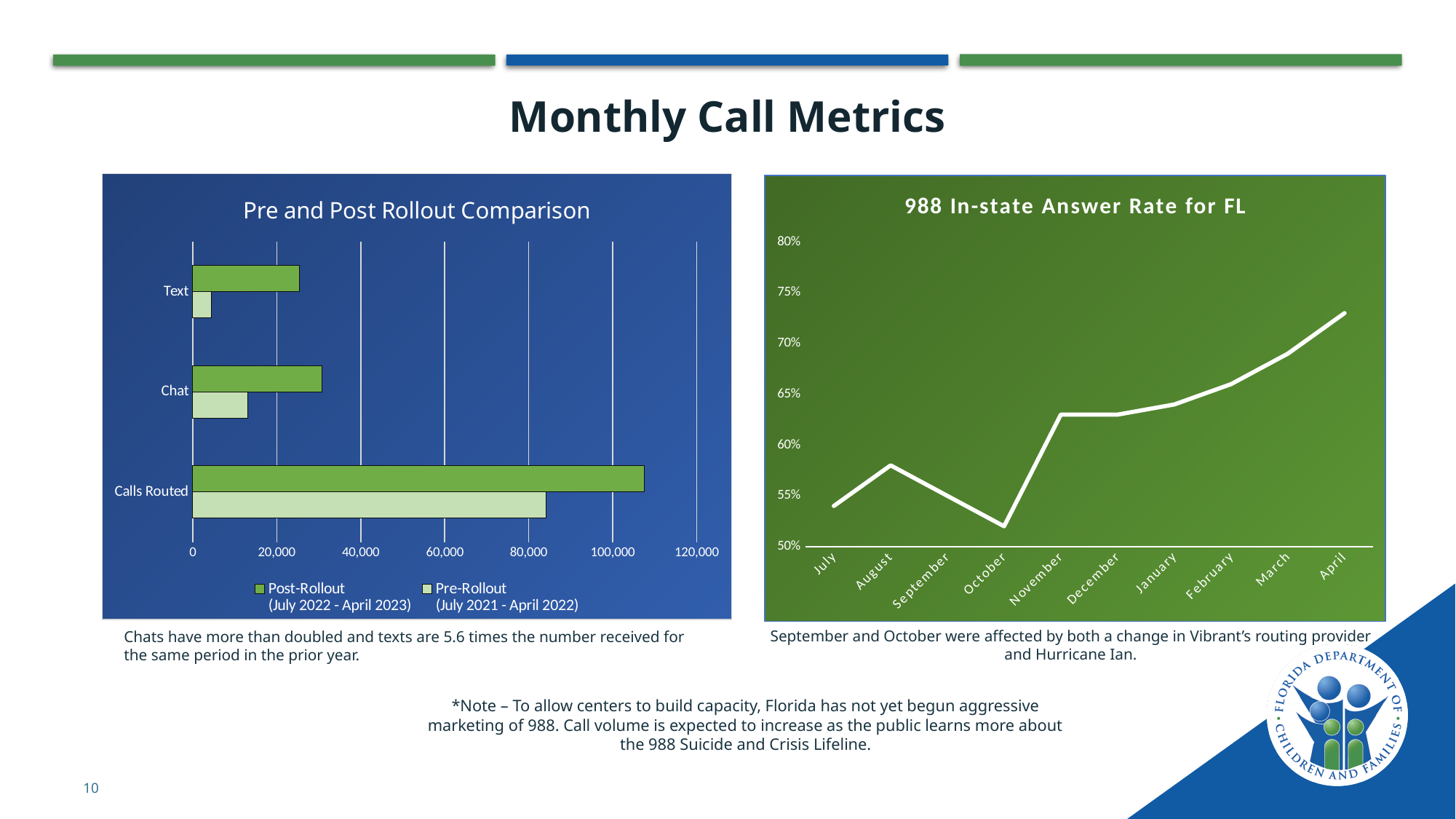
In the 'Pre and Post Rollout Comparison' chart, is the Pre-Rollout value for Chat greater or less than 20,000? less In the 'Pre and Post Rollout Comparison' chart, which category has the highest Post-Rollout value? Calls Routed In the '988 In-state Answer Rate for FL' chart, is the answer rate for April greater or less than 70%? greater What kind of chart is the 'Pre and Post Rollout Comparison' chart? bar chart In the 'Pre and Post Rollout Comparison' chart, which is larger for Text: the Post-Rollout value or the Pre-Rollout value? Post-Rollout How many months are plotted in the '988 In-state Answer Rate for FL' chart? 10 What kind of chart is the '988 In-state Answer Rate for FL' chart? line chart In the 'Pre and Post Rollout Comparison' chart, is the Post-Rollout value for Calls Routed greater or less than 100,000? greater In the '988 In-state Answer Rate for FL' chart, which month has the lowest answer rate? October How many categories are shown in the 'Pre and Post Rollout Comparison' chart? 3 How many series does the legend of the 'Pre and Post Rollout Comparison' chart list? 2 In the '988 In-state Answer Rate for FL' chart, does the answer rate rise or fall from November to April? rise